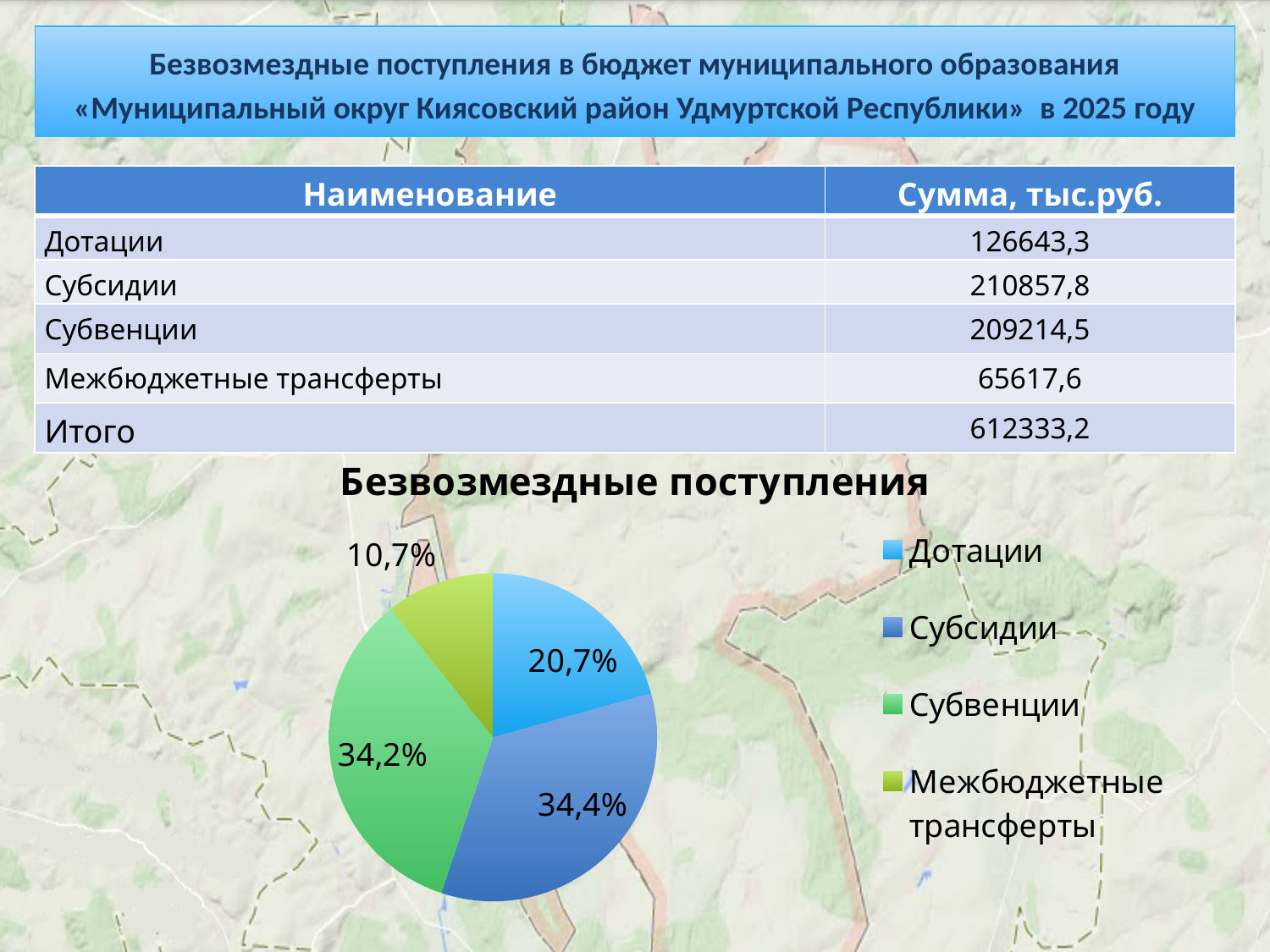
What is the difference in percentage points between the Субсидии slice and the Дотации slice? 13,7 How many entries does the legend list? 4 Which category has the largest slice of the pie? Субсидии How many slices does the pie chart have? 4 What share of the pie does Дотации have? 20,7% What is the title of the pie chart? Безвозмездные поступления What share of the pie does Субсидии have? 34,4% What share of the pie does Субвенции have? 34,2% Which slice is larger, Дотации or Межбюджетные трансферты? Дотации What kind of chart is shown on the slide? Pie chart Which category has the smallest slice of the pie? Межбюджетные трансферты